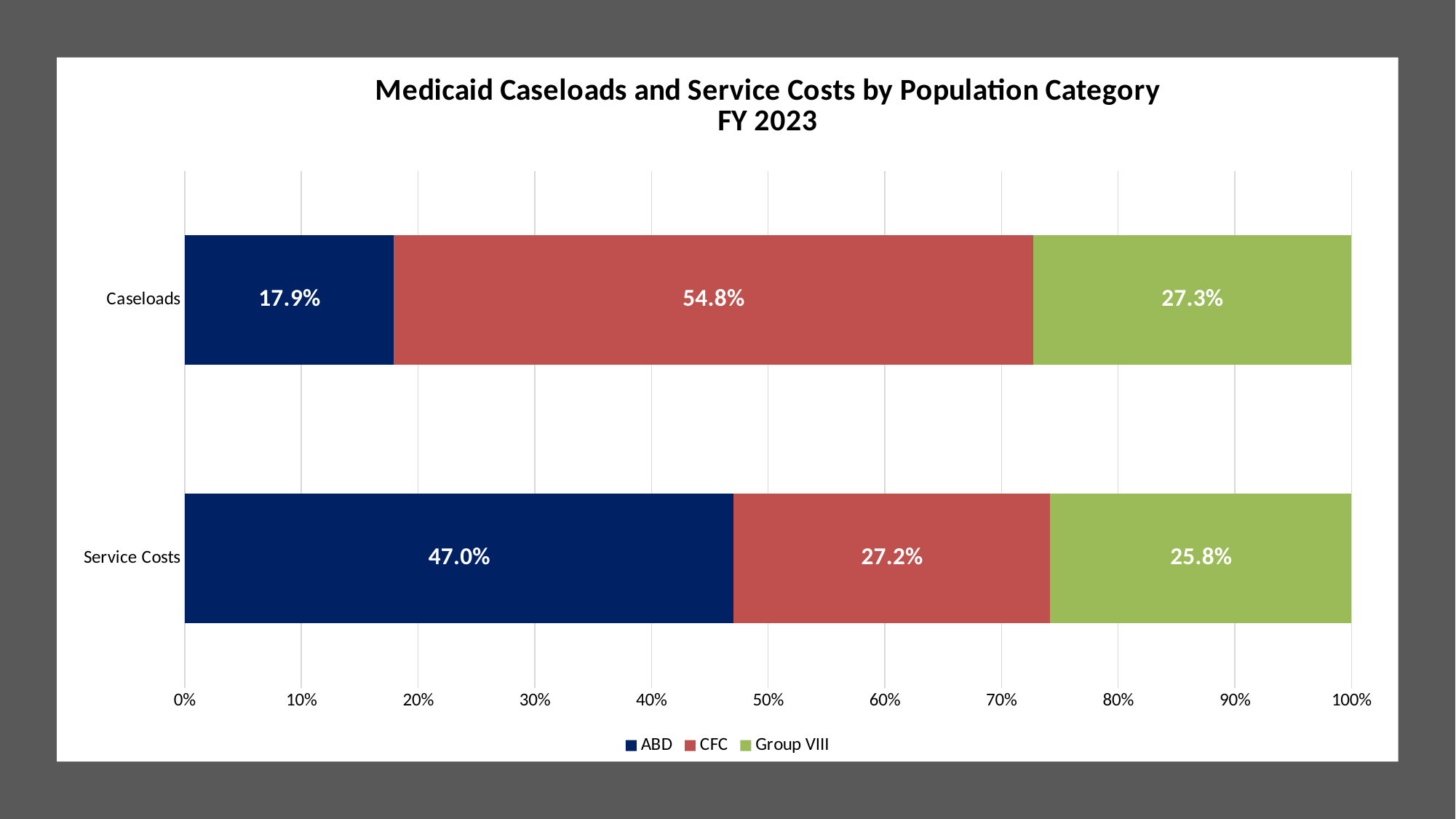
Which is larger: the CFC share of Caseloads or the CFC share of Service Costs? CFC share of Caseloads How many bars (categories) are shown on the chart? 2 What kind of chart is shown on the slide? Stacked bar chart What is the title of the chart? Medicaid Caseloads and Service Costs by Population Category FY 2023 How many series does the legend list? 3 What is the ABD share of Caseloads? 17.9% What is the CFC share of Service Costs? 27.2% Which population category has the largest share of Caseloads? CFC Is the ABD share of Service Costs greater or less than 40%? greater What is the Group VIII share of Caseloads? 27.3% What is the difference between the ABD share of Service Costs and the ABD share of Caseloads? 29.1% Which population category has the smallest share of Service Costs? Group VIII